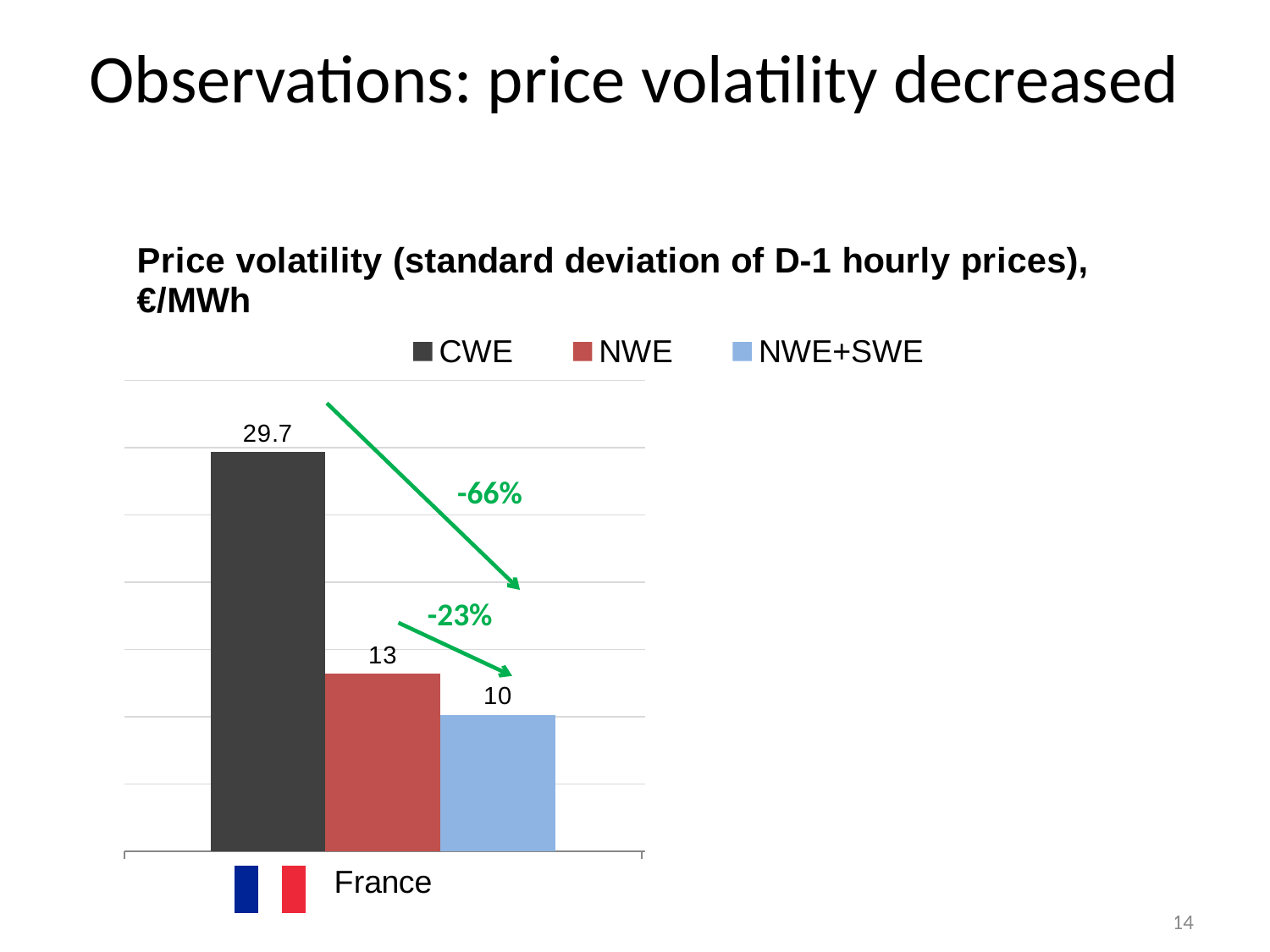
What unit is given in the chart title? €/MWh What is the price volatility value for the NWE+SWE series for France? 10 Which series has the highest price volatility for France? CWE What is the price volatility value for the NWE series for France? 13 What is the difference between the NWE and NWE+SWE values for France? 3 Which series has the lowest price volatility for France? NWE+SWE What is the price volatility value for the CWE series for France? 29.7 What is the difference between the CWE and NWE+SWE values for France? 19.7 What kind of chart is shown on the slide? Bar chart How many series does the legend list? 3 What percentage change is annotated between the CWE and NWE+SWE bars? -66% Which is larger for France, the CWE value or the NWE value? CWE